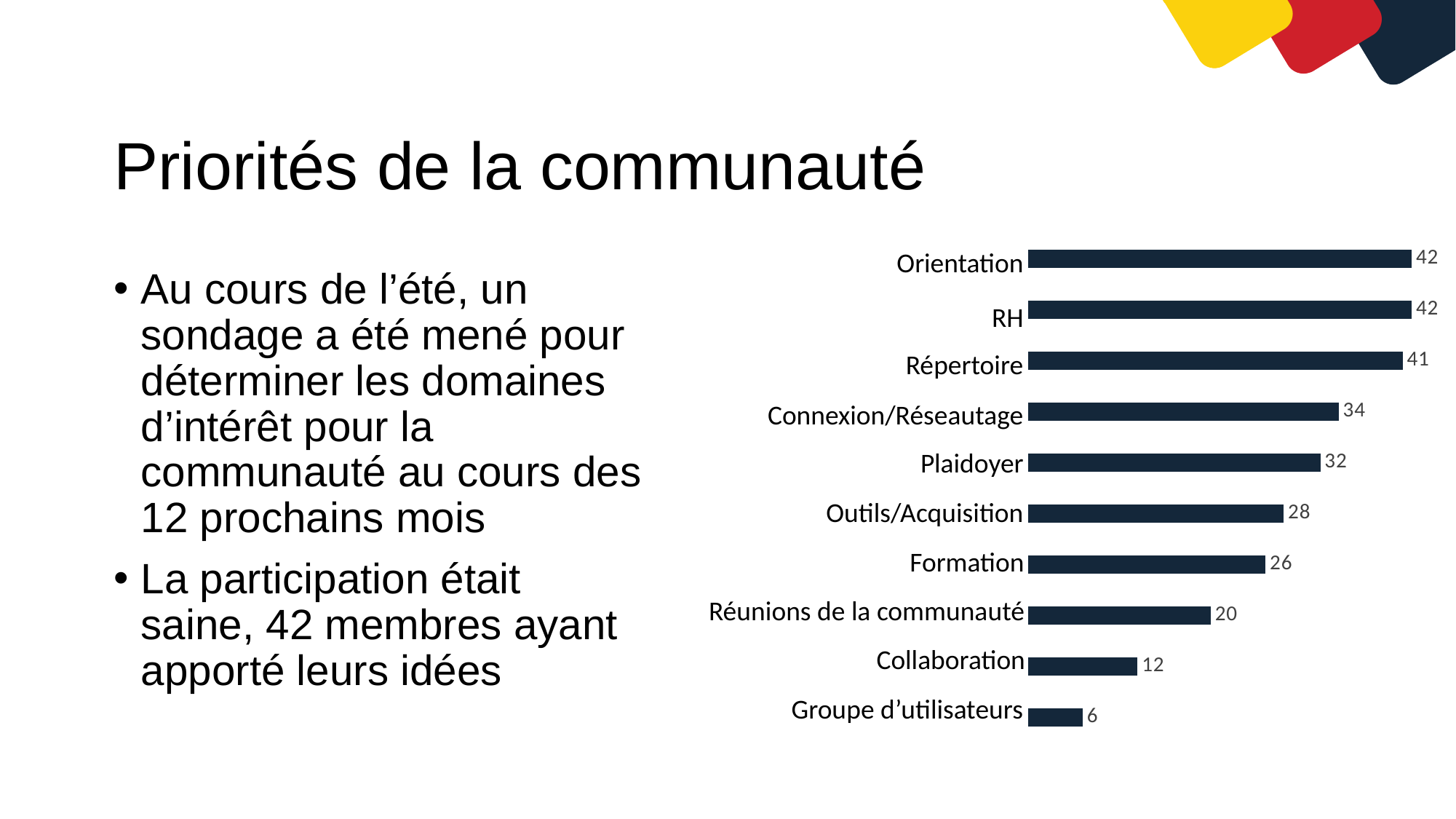
What is the value for Connexion/Réseautage? 34 Which is larger, the value for Réunions de la communauté or the value for Collaboration? Réunions de la communauté What kind of chart is shown on the slide? Bar chart What is the value for Formation? 26 How many categories are shown in the chart? 10 What is the difference between the values for Orientation and Groupe d’utilisateurs? 36 What is the value for Collaboration? 12 What is the difference between the values for Répertoire and Outils/Acquisition? 13 Which category has the lowest value? Groupe d’utilisateurs Which is larger, the value for Plaidoyer or the value for Formation? Plaidoyer What is the value for Plaidoyer? 32 What value do both Orientation and RH share? 42